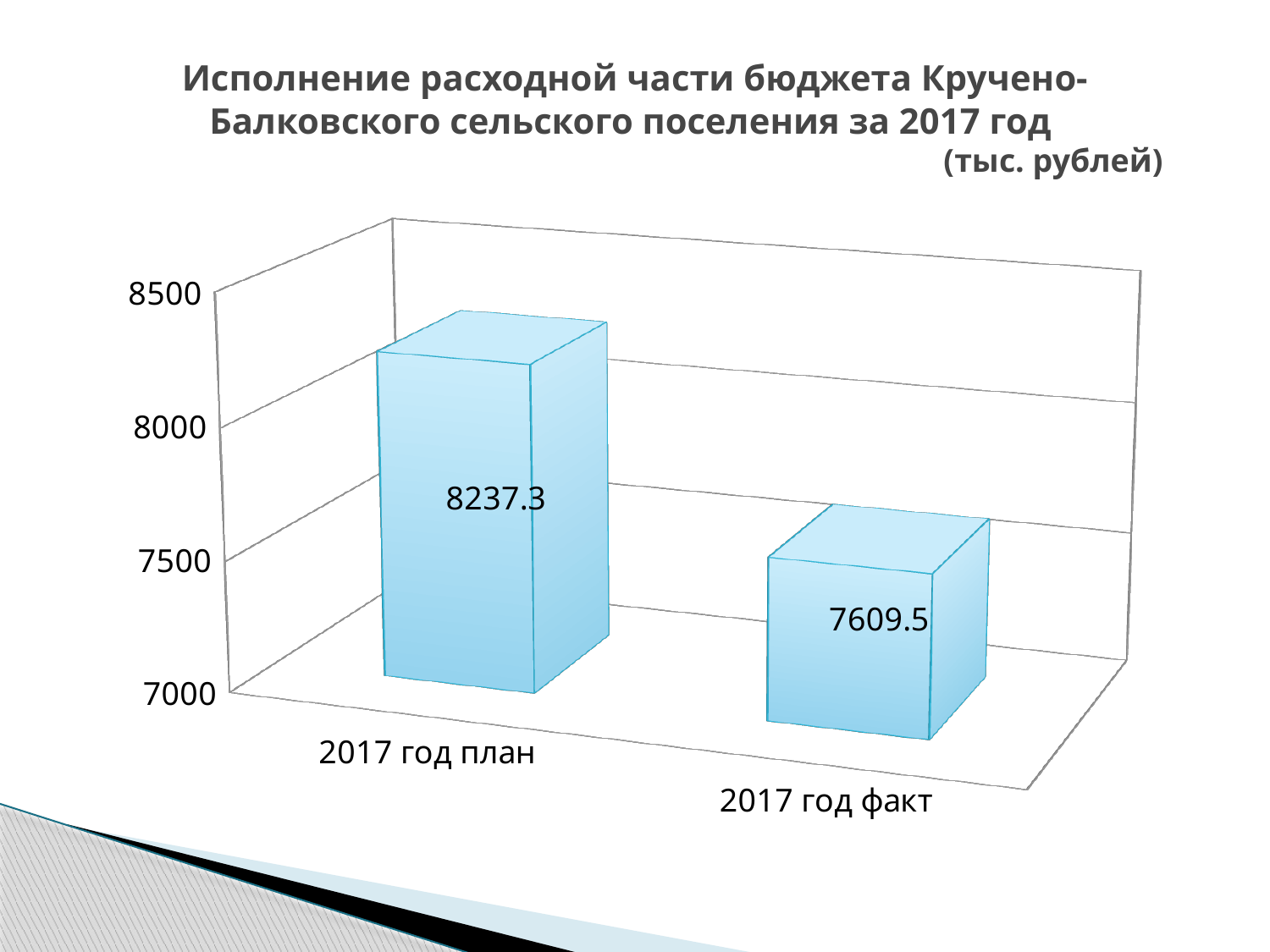
Which category has the lowest value? 2017 год факт Is the value for "2017 год факт" greater or less than 8000? less Which category has the highest value? 2017 год план In what units are the values on the chart expressed, according to the slide? тыс. рублей What is the difference between the values for "2017 год план" and "2017 год факт"? 627.8 What is the value for "2017 год план"? 8237.3 Do the values rise or fall from "2017 год план" to "2017 год факт"? fall Which is larger: the value for "2017 год план" or "2017 год факт"? 2017 год план What kind of chart is shown on the slide? bar chart What is the value for "2017 год факт"? 7609.5 How many categories are shown in the chart? 2 Is the value for "2017 год план" greater or less than 8000? greater